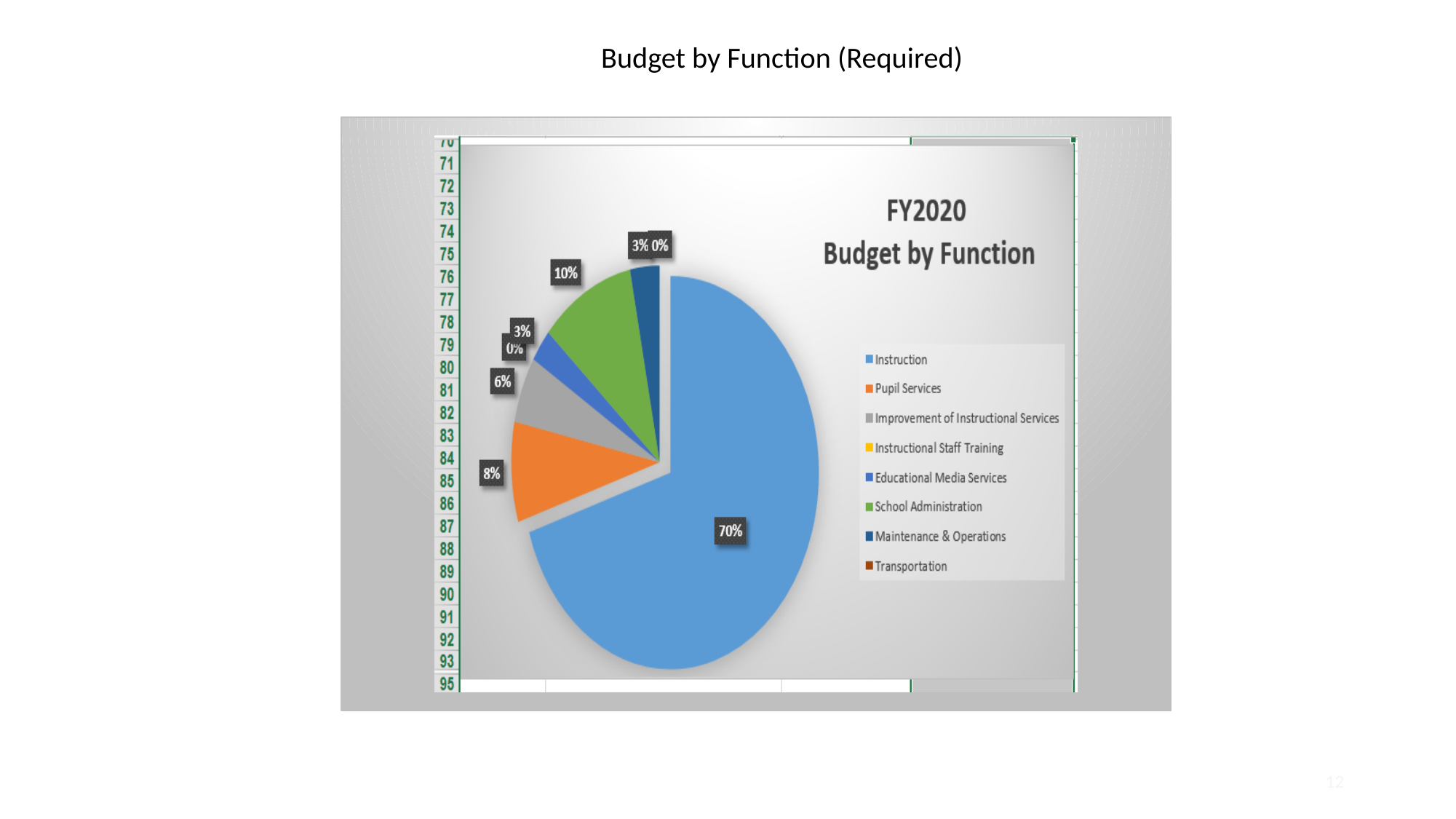
What kind of chart is shown on the slide? pie chart What share of the FY2020 budget goes to Improvement of Instructional Services? 6% Which colour represents Instruction in the pie chart? blue Is the share for Instruction greater or less than 50%? greater Which has a larger share of the budget, School Administration or Pupil Services? School Administration What is the title of the chart? FY2020 Budget by Function What share of the FY2020 budget goes to Pupil Services? 8% What share of the FY2020 budget goes to School Administration? 10% How many percentage points larger is the Instruction share than the Pupil Services share? 62 percentage points Which function has the largest share of the FY2020 budget? Instruction What share of the FY2020 budget goes to Instruction? 70% How many functions are listed in the chart's legend? 8